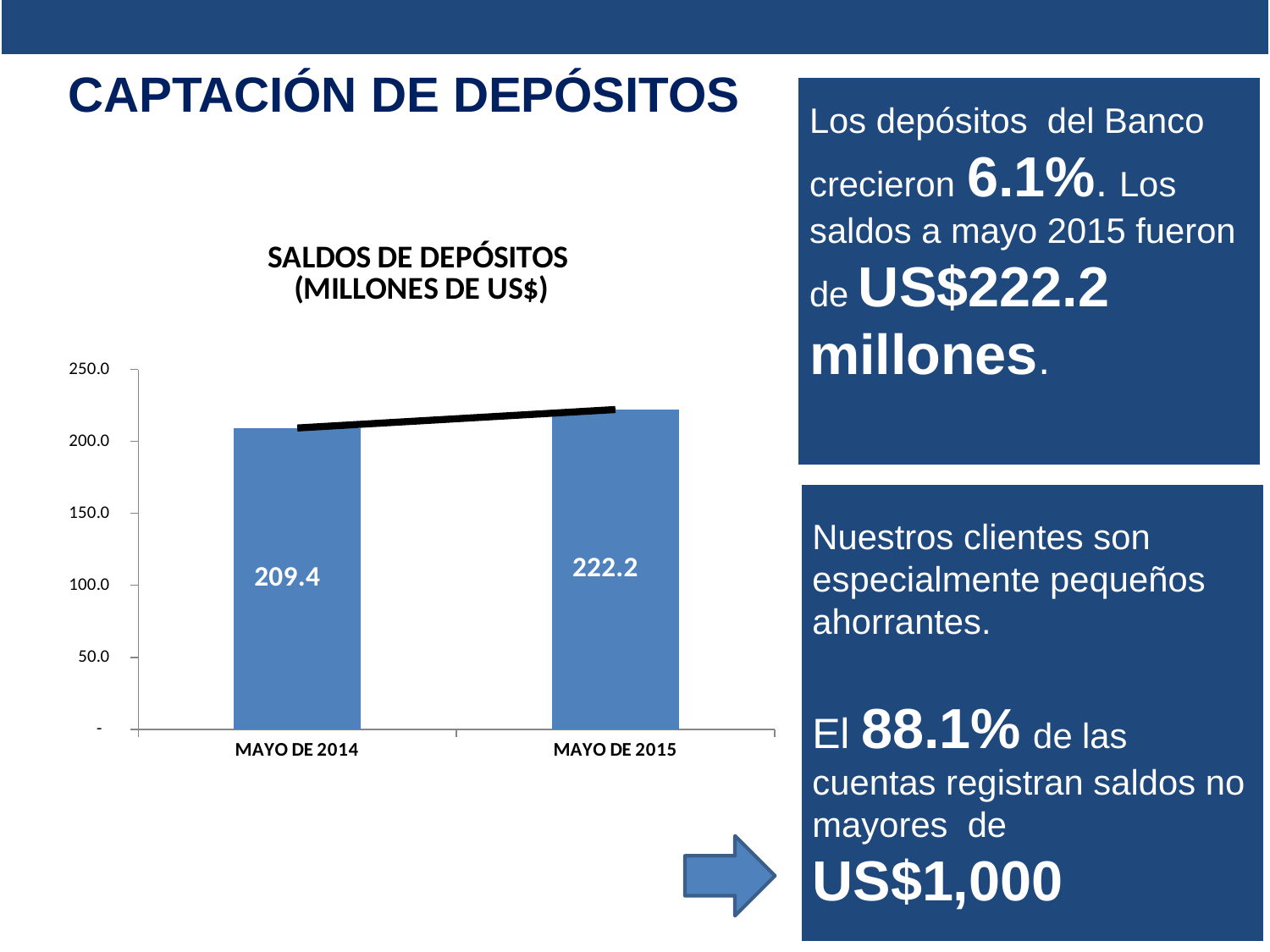
How many categories are shown on the x axis? 2 What kind of chart is shown? bar chart Which category has the lowest value? MAYO DE 2014 Is the value for MAYO DE 2014 greater or less than 200.0? greater What is the title of the chart? SALDOS DE DEPÓSITOS (MILLONES DE US$) Which is larger, the value for MAYO DE 2014 or MAYO DE 2015? MAYO DE 2015 What is the difference between the values for MAYO DE 2015 and MAYO DE 2014? 12.8 What is the value for MAYO DE 2015? 222.2 What is the value for MAYO DE 2014? 209.4 Do the values rise or fall from MAYO DE 2014 to MAYO DE 2015? rise Is the value for MAYO DE 2015 greater or less than 250.0? less Which category has the highest value? MAYO DE 2015